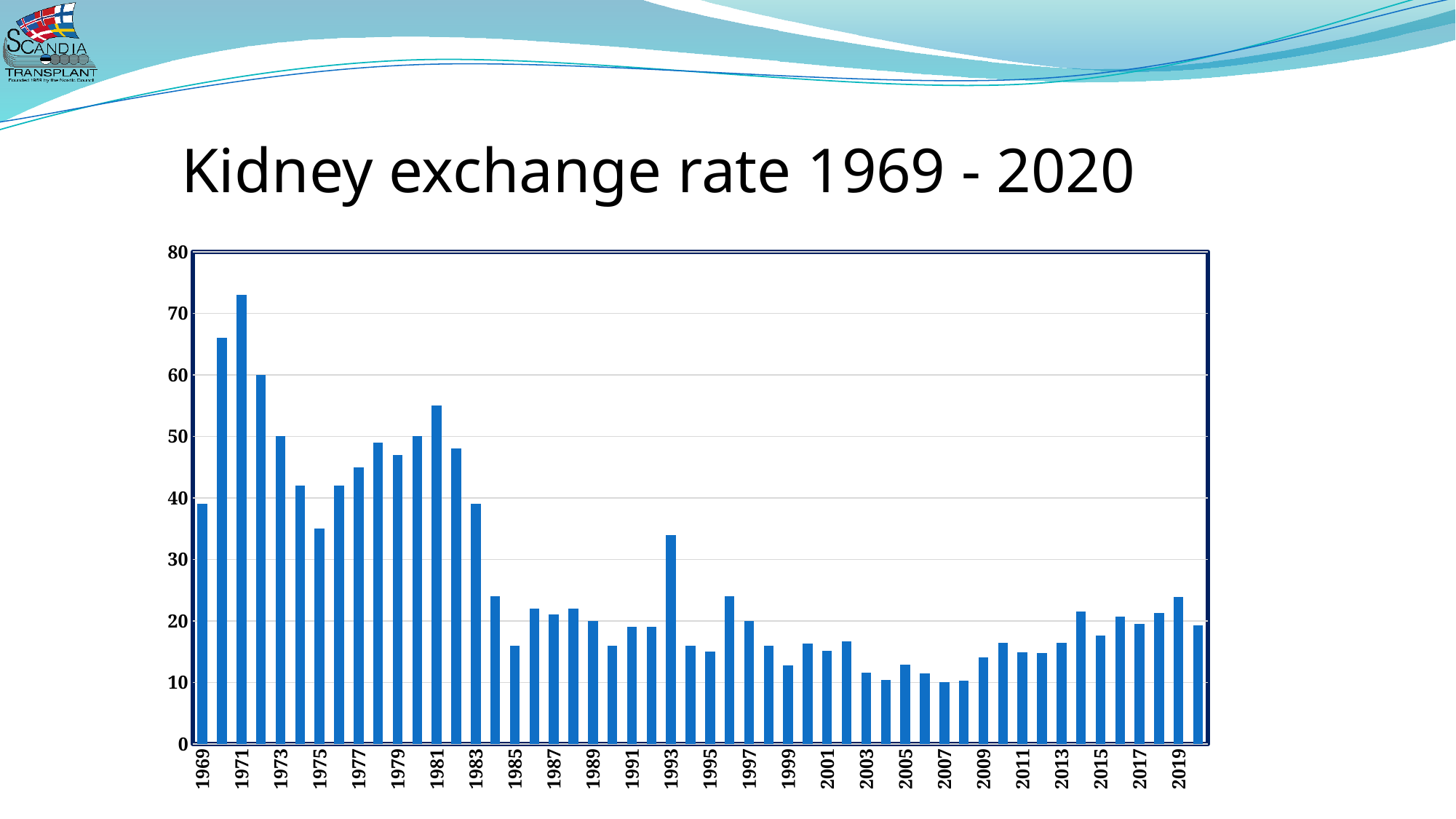
Do the values rise or fall from 1969 to 1971? rise Which year has the highest kidney exchange rate? 1971 Which year has the larger value, 1993 or 1995? 1993 Is the value for 2007 greater or less than 20? less What kind of chart is shown on the slide? bar chart Which year has the larger value, 1970 or 1971? 1971 What is the title of the chart on the slide? Kidney exchange rate 1969 - 2020 Is the value for 2019 greater or less than 20? greater Is the value for 1981 greater or less than 50? greater Do the values rise or fall from 1983 to 1985? fall